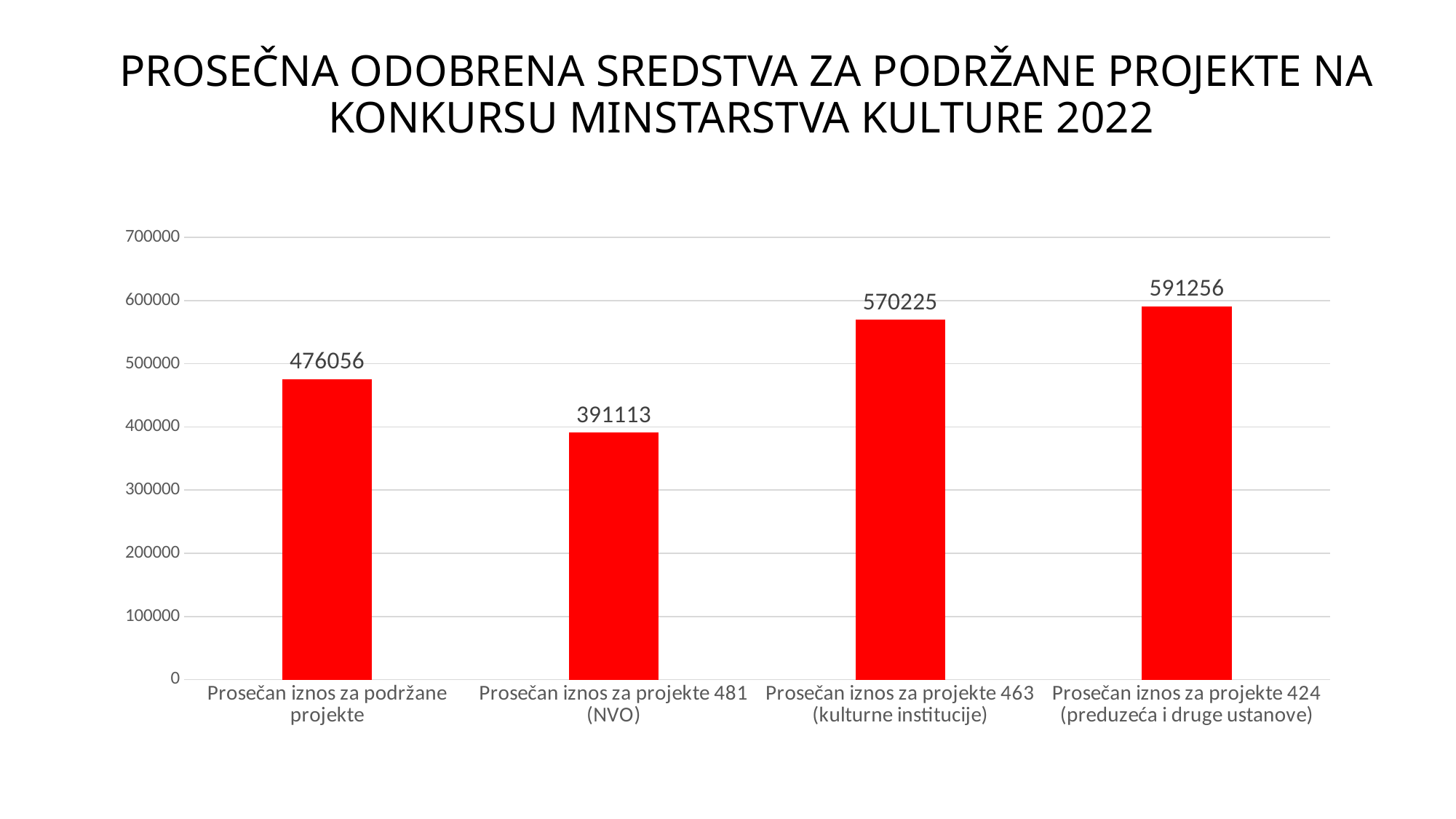
What is the value for 'Prosečan iznos za projekte 424 (preduzeća i druge ustanove)'? 591256 Which category has the lowest value? Prosečan iznos za projekte 481 (NVO) How many categories are shown in the chart? 4 Which category has the highest value? Prosečan iznos za projekte 424 (preduzeća i druge ustanove) What kind of chart is shown on the slide? bar chart What is the value for 'Prosečan iznos za podržane projekte'? 476056 What is the difference between the values for 'Prosečan iznos za projekte 424 (preduzeća i druge ustanove)' and 'Prosečan iznos za projekte 481 (NVO)'? 200143 What is the value for 'Prosečan iznos za projekte 463 (kulturne institucije)'? 570225 Is the value for 'Prosečan iznos za projekte 481 (NVO)' greater or less than 400000? less What is the title of the chart? PROSEČNA ODOBRENA SREDSTVA ZA PODRŽANE PROJEKTE NA KONKURSU MINSTARSTVA KULTURE 2022 What is the value for 'Prosečan iznos za projekte 481 (NVO)'? 391113 Which is larger: the value for 'Prosečan iznos za projekte 463 (kulturne institucije)' or 'Prosečan iznos za podržane projekte'? Prosečan iznos za projekte 463 (kulturne institucije)